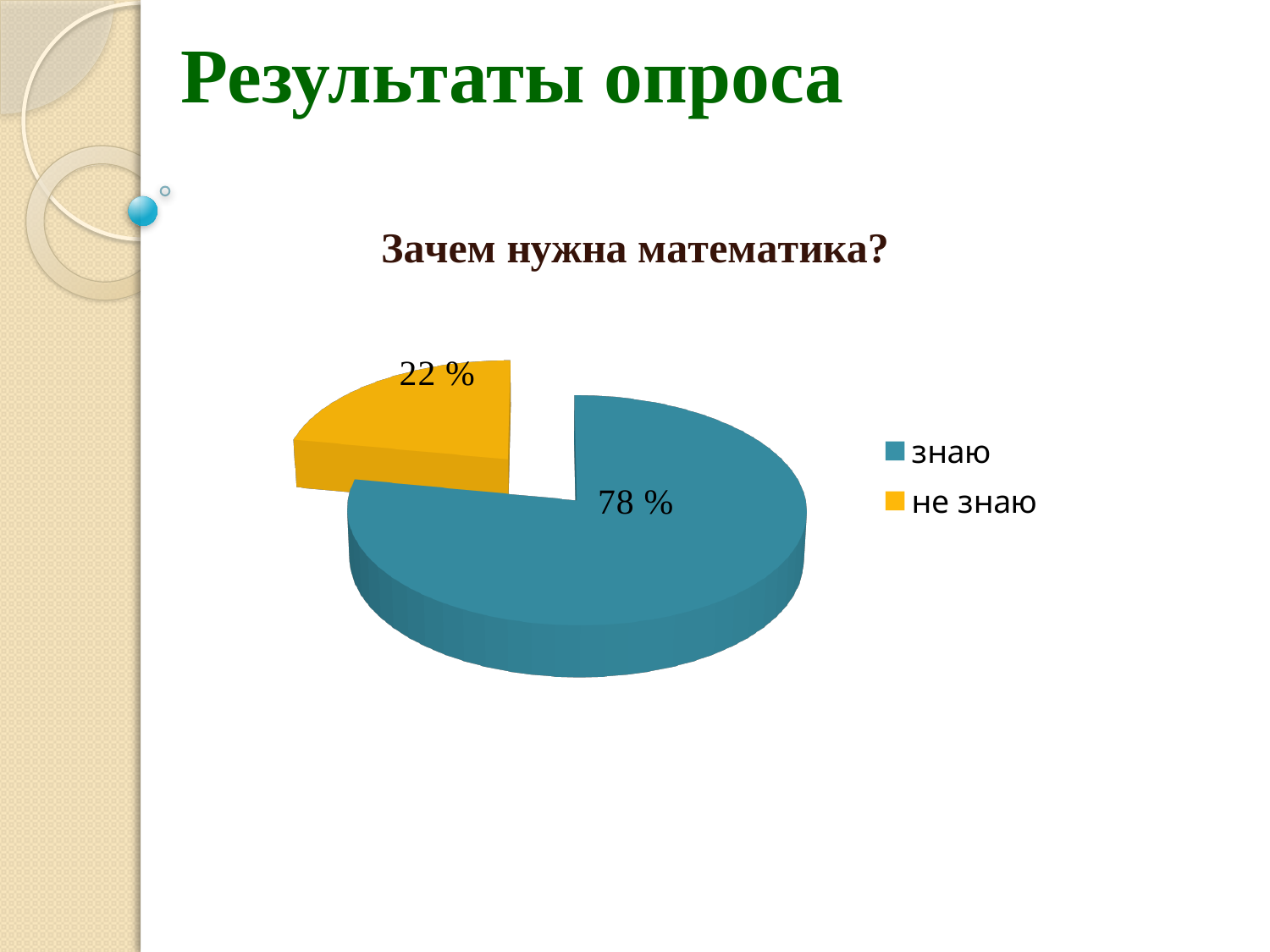
What share of the pie does the "не знаю" slice represent? 22 % What kind of chart is shown on the slide? pie chart What colour is the "не знаю" slice? yellow What is the title of the chart? Зачем нужна математика? Which category has the smallest slice of the pie? не знаю Which is larger, the "знаю" slice or the "не знаю" slice? знаю What is the difference in percentage points between the "знаю" and "не знаю" slices? 56 What share of the pie does the "знаю" slice represent? 78 % How many entries does the legend list? 2 Which category has the largest slice of the pie? знаю How many categories does the pie chart have? 2